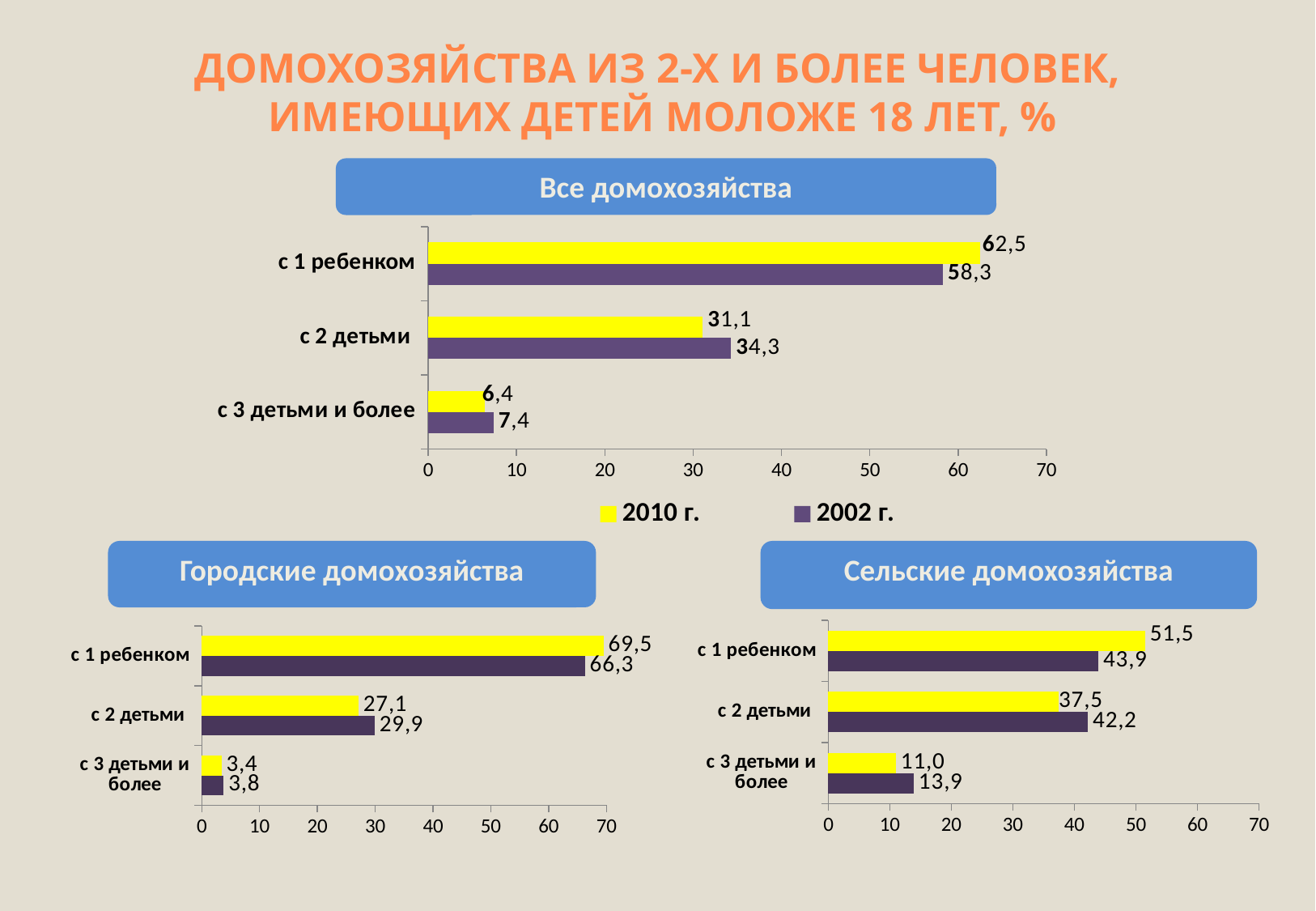
In the 'Городские домохозяйства' chart, is the 2010 г. value for 'с 2 детьми' greater or less than 30? less In the 'Городские домохозяйства' chart, what is the 2010 г. value for 'с 3 детьми и более'? 3,4 In the 'Сельские домохозяйства' chart, which category has the lowest 2010 г. value? с 3 детьми и более In the 'Городские домохозяйства' chart, which category has the highest 2002 г. value? с 1 ребенком How many series does the legend list? 2 In the 'Все домохозяйства' chart, what is the 2002 г. value for 'с 2 детьми'? 34,3 What type of chart is the 'Сельские домохозяйства' chart? Bar chart In the 'Все домохозяйства' chart, what is the difference between the 2010 г. and 2002 г. values for 'с 1 ребенком'? 4,2 In the 'Сельские домохозяйства' chart, which is larger for 'с 2 детьми': the 2010 г. value or the 2002 г. value? 2002 г. In the 'Сельские домохозяйства' chart, what is the 2002 г. value for 'с 1 ребенком'? 43,9 How many categories are shown in the 'Все домохозяйства' chart? 3 In the 'Все домохозяйства' chart, what is the 2010 г. value for 'с 1 ребенком'? 62,5